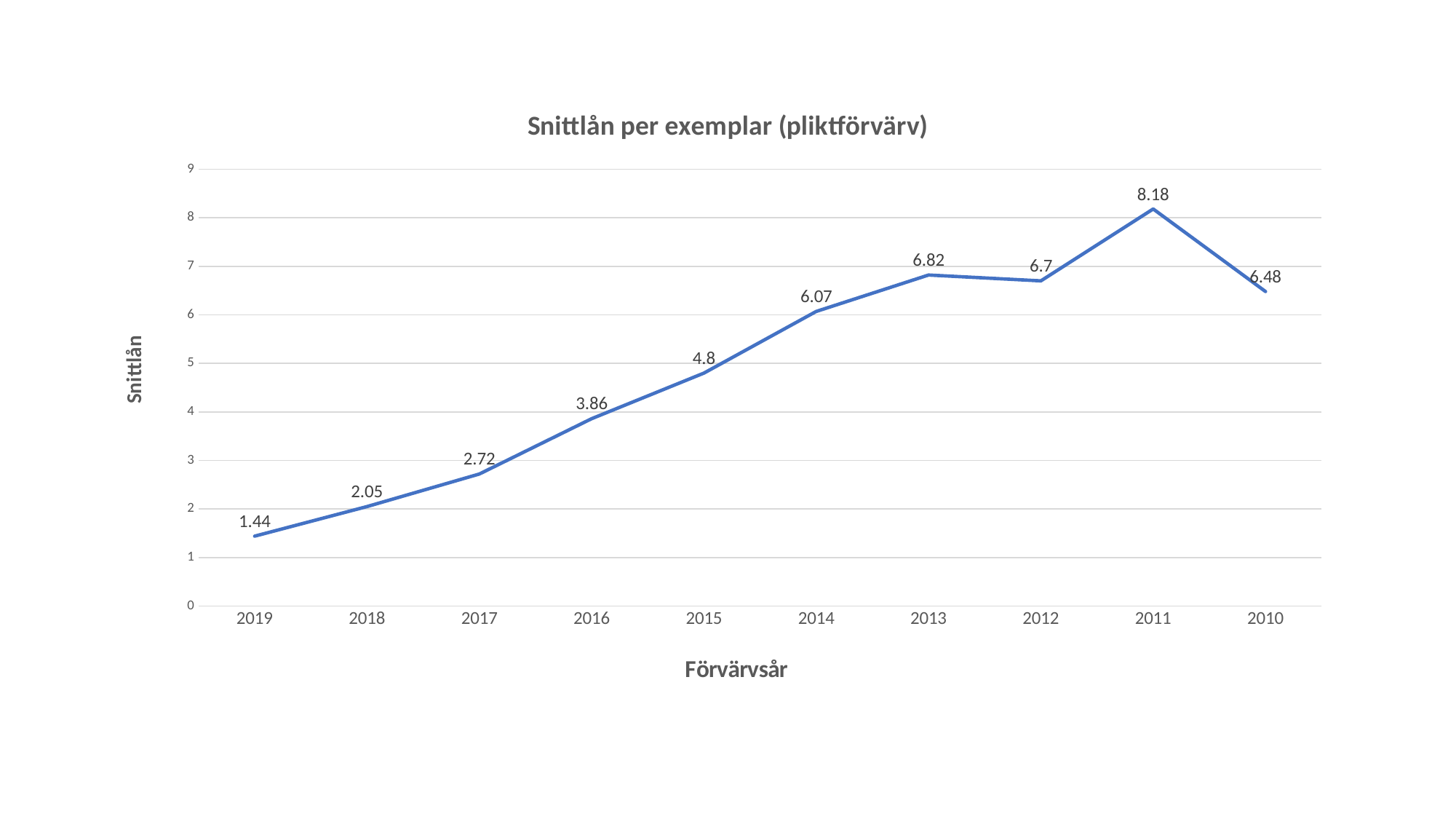
Is the value for 2016 greater or less than 4? less What is the difference between the values for 2011 and 2010? 1.7 What is the title of the chart? Snittlån per exemplar (pliktförvärv) What is the value for 2011? 8.18 Which year has the highest value? 2011 Which is larger, the value for 2013 or the value for 2012? 2013 What is the value for 2015? 4.8 What kind of chart is this? line chart How many years are shown on the x axis? 10 What is the value for 2019? 1.44 Which year has the lowest value? 2019 What is the difference between the values for 2014 and 2015? 1.27